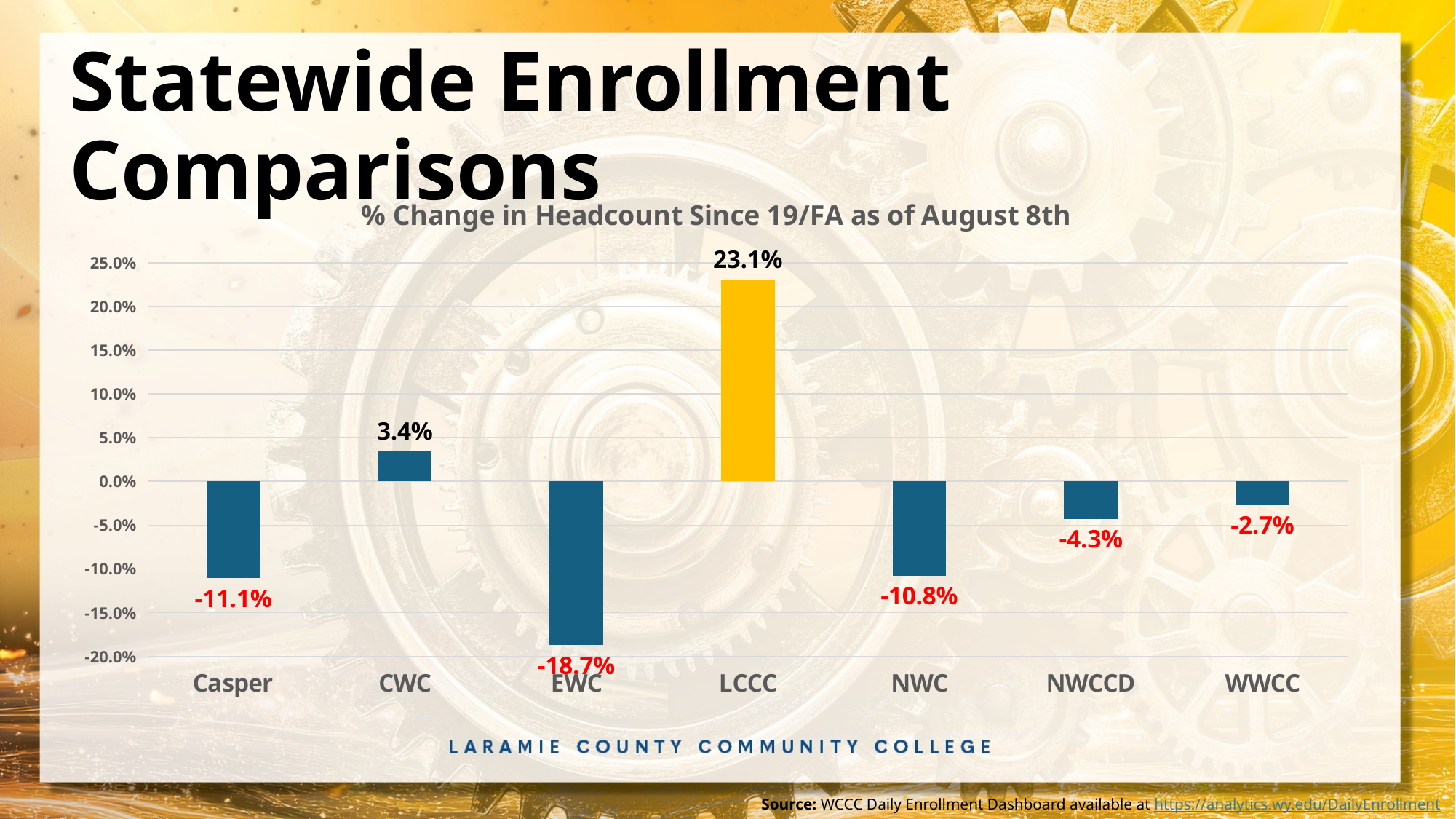
Which has a larger % change in headcount, NWC or WWCC? WWCC What is the % change in headcount for LCCC? 23.1% What is the % change in headcount for EWC? -18.7% What is the difference between the % change for LCCC and CWC? 19.7 percentage points What kind of chart is shown on the slide? Bar chart Is the value for LCCC greater or less than 20.0%? greater Which college has the highest % change in headcount? LCCC What is the % change in headcount for Casper? -11.1% Which college has the lowest % change in headcount? EWC How many colleges are shown on the chart? 7 What is the title of the chart? % Change in Headcount Since 19/FA as of August 8th What is the % change in headcount for NWCCD? -4.3%